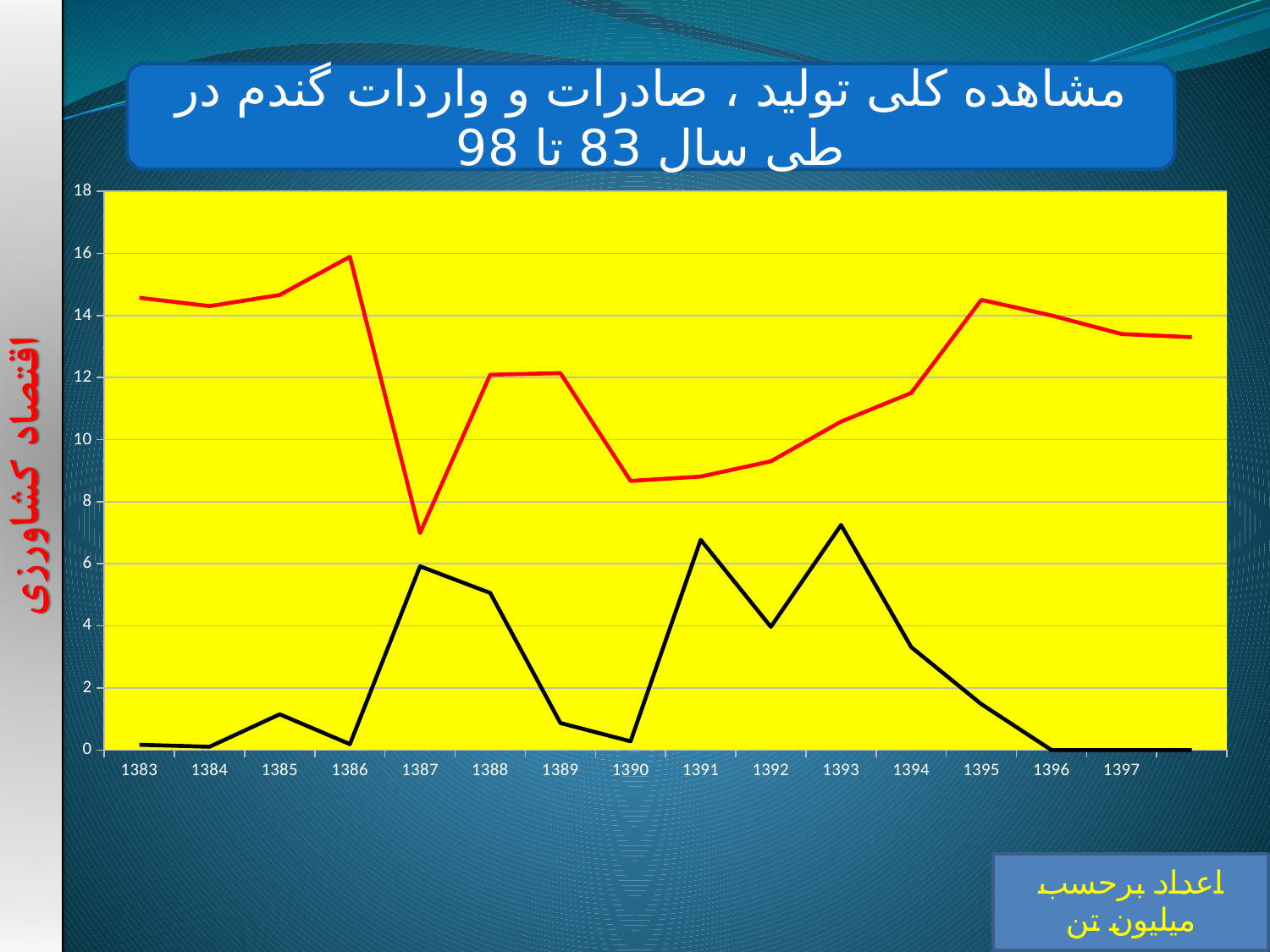
How many year labels are shown on the x axis of the chart? 15 According to the note on the slide, what unit are the numbers in? میلیون تن How many lines are plotted on the chart? 2 Is the value of the black line in 1392 greater or less than 6? less Is the value of the red line in 1387 greater or less than 8? less Which line has the higher value in 1387, the red line or the black line? the red line Is the value of the black line in 1391 greater or less than 6? greater In which year does the red line reach its highest value? 1386 In which year does the red line reach its lowest value? 1387 Does the red line rise or fall between 1390 and 1395? rise What kind of chart is shown on the slide? line chart